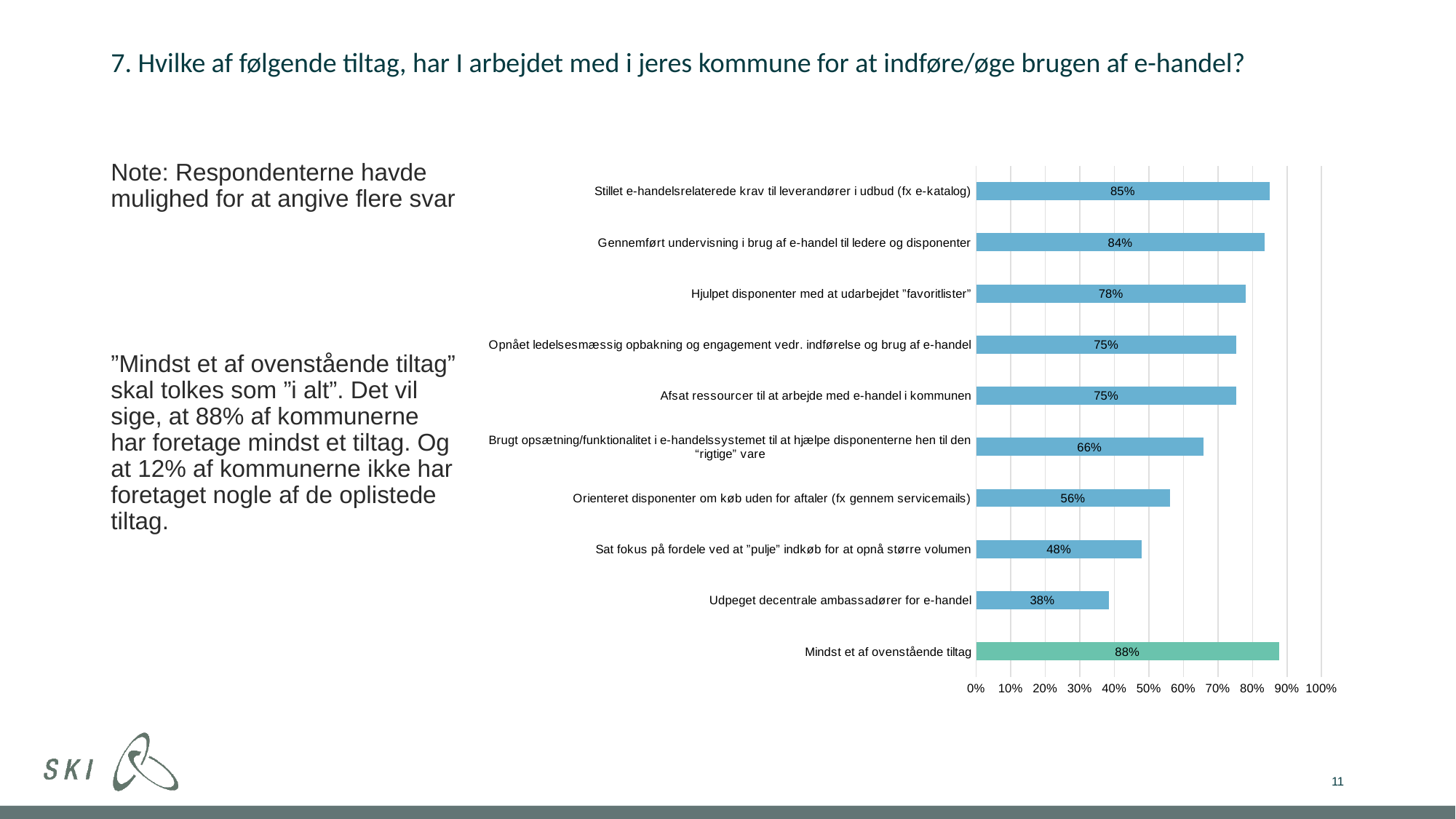
What is the difference between the values for "Hjulpet disponenter med at udarbejdet "favoritlister"" and "Sat fokus på fordele ved at "pulje" indkøb for at opnå større volumen"? 30% What is the value for "Orienteret disponenter om køb uden for aftaler (fx gennem servicemails)"? 56% Which is larger: the value for "Gennemført undervisning i brug af e-handel til ledere og disponenter" or the value for "Afsat ressourcer til at arbejde med e-handel i kommunen"? Gennemført undervisning i brug af e-handel til ledere og disponenter What is the value for "Stillet e-handelsrelaterede krav til leverandører i udbud (fx e-katalog)"? 85% Which category has the lowest value? Udpeget decentrale ambassadører for e-handel What is the value for "Udpeget decentrale ambassadører for e-handel"? 38% How many categories are shown in the chart? 10 Is the value for "Brugt opsætning/funktionalitet i e-handelssystemet til at hjælpe disponenterne hen til den "rigtige" vare" greater or less than 60%? greater What is the value for "Mindst et af ovenstående tiltag"? 88% What kind of chart is shown on the slide? bar chart Which category has the highest value? Mindst et af ovenstående tiltag Which bar is shown in a different colour (green) from the others? Mindst et af ovenstående tiltag